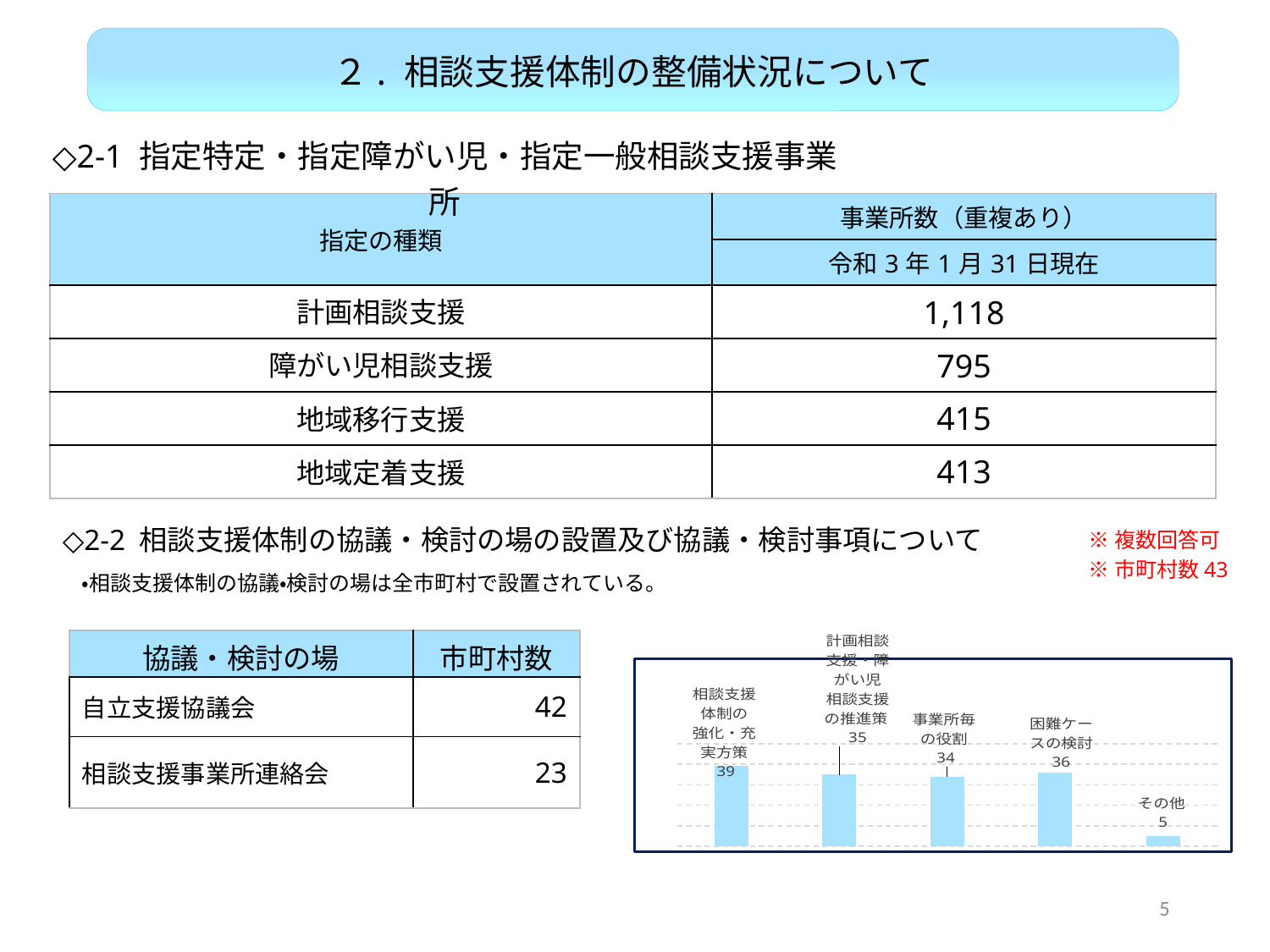
In the bar chart, what is the value for 計画相談支援・障がい児相談支援の推進策? 35 In the bar chart, what is the value for 困難ケースの検討? 36 In the bar chart, what is the value for その他? 5 In the bar chart, which is larger: the value for 困難ケースの検討 or the value for その他? 困難ケースの検討 In the bar chart, which category has the lowest value? その他 In the bar chart, what is the difference between the values for 困難ケースの検討 and 事業所毎の役割? 2 How many categories are shown in the bar chart? 5 What kind of chart is shown at the bottom right of the slide? bar chart In the bar chart, what is the difference between the values for 相談支援体制の強化・充実方策 and その他? 34 In the bar chart, what is the value for 相談支援体制の強化・充実方策? 39 In the bar chart, which category has the highest value? 相談支援体制の強化・充実方策 In the bar chart, what is the value for 事業所毎の役割? 34